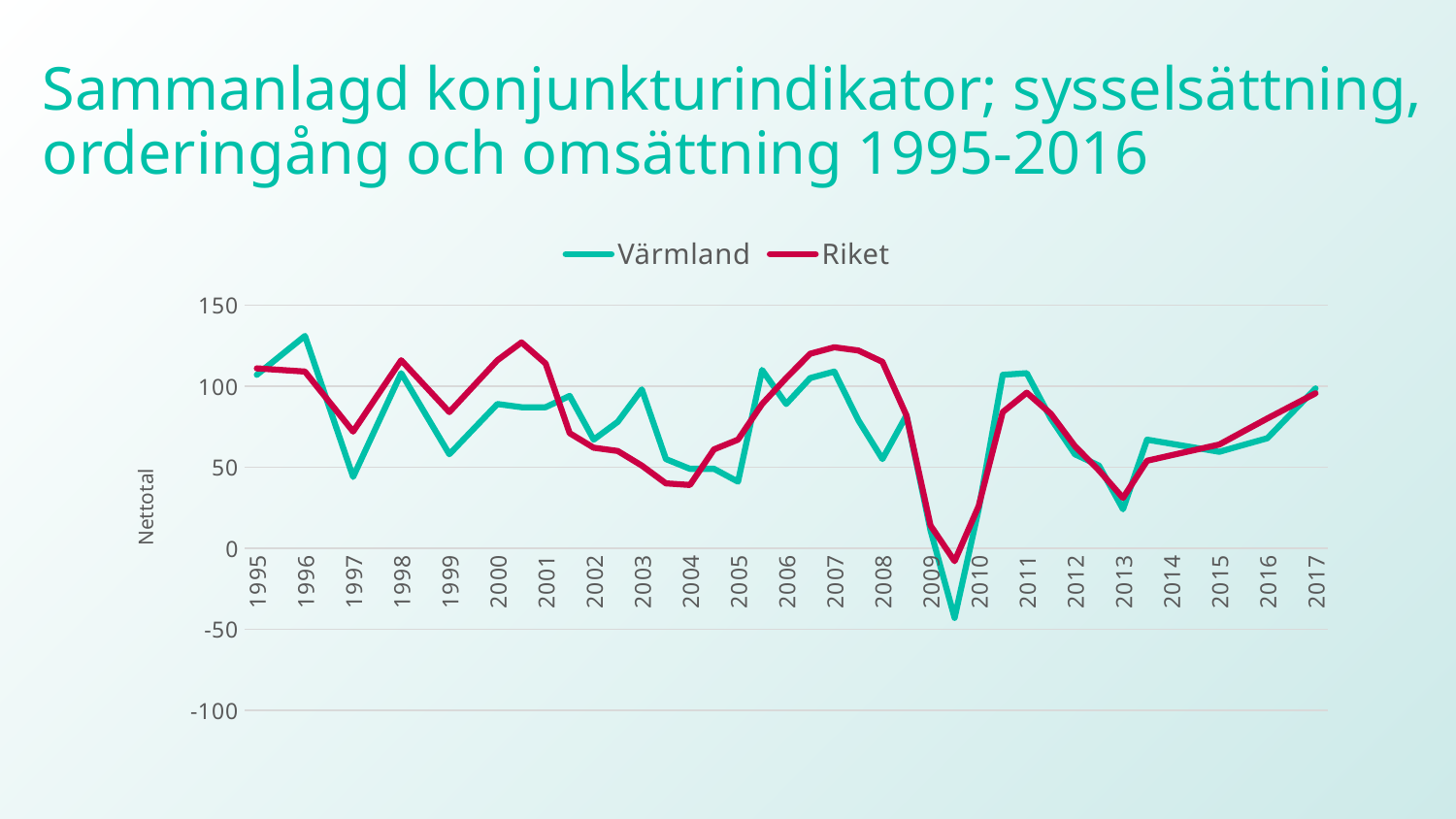
Is the value for Värmland in 2009 greater or less than 0? less What are the two series named in the legend? Värmland and Riket In 2009, which series has the lower value, Värmland or Riket? Värmland In which year does the Värmland series reach its highest value? 1996 What kind of chart is shown on the slide? line chart In which year does the Riket series reach its lowest value? 2009 What is the label on the vertical axis? Nettotal How many series does the legend list? 2 In which year does the Värmland series reach its lowest value? 2009 Is the value for Riket in 2013 greater or less than 50? less How many years are labelled on the x axis? 23 Is the value for Värmland in 1996 greater or less than 100? greater